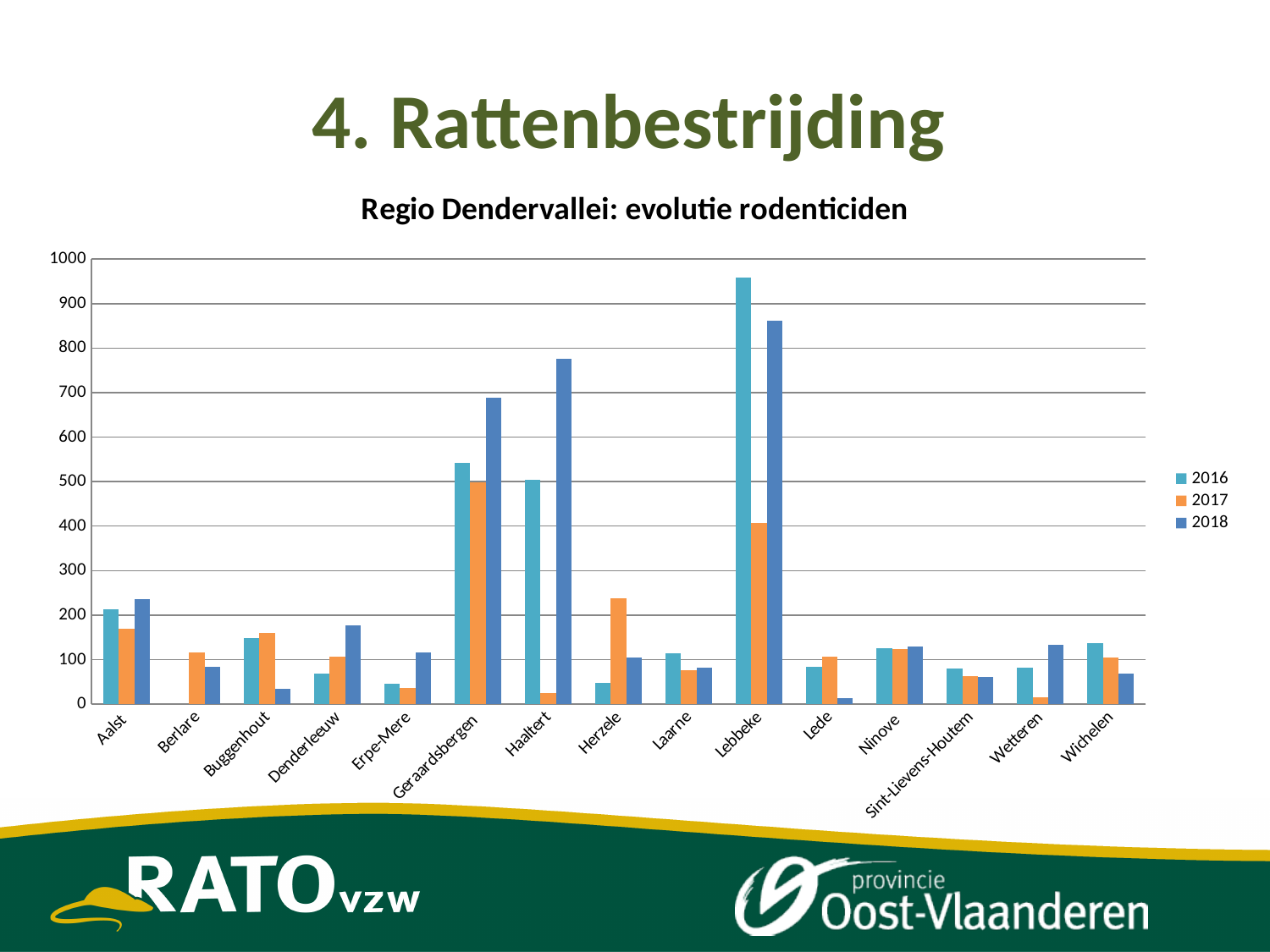
What kind of chart is shown on the slide? bar chart Which municipality has the lowest 2018 value? Lede For Haaltert, which is larger: the 2016 value or the 2018 value? 2018 Which municipality has the highest 2016 value? Lebbeke Which municipality has the highest 2017 value? Geraardsbergen How many series does the legend list? 3 What is the title of the chart? Regio Dendervallei: evolutie rodenticiden How many municipalities are shown on the x axis? 15 For Herzele, which is larger: the 2016 value or the 2017 value? 2017 Is the 2016 value for Lebbeke greater or less than 900? greater Is the 2018 value for Lede greater or less than 100? less Is the 2018 value for Haaltert greater or less than 700? greater